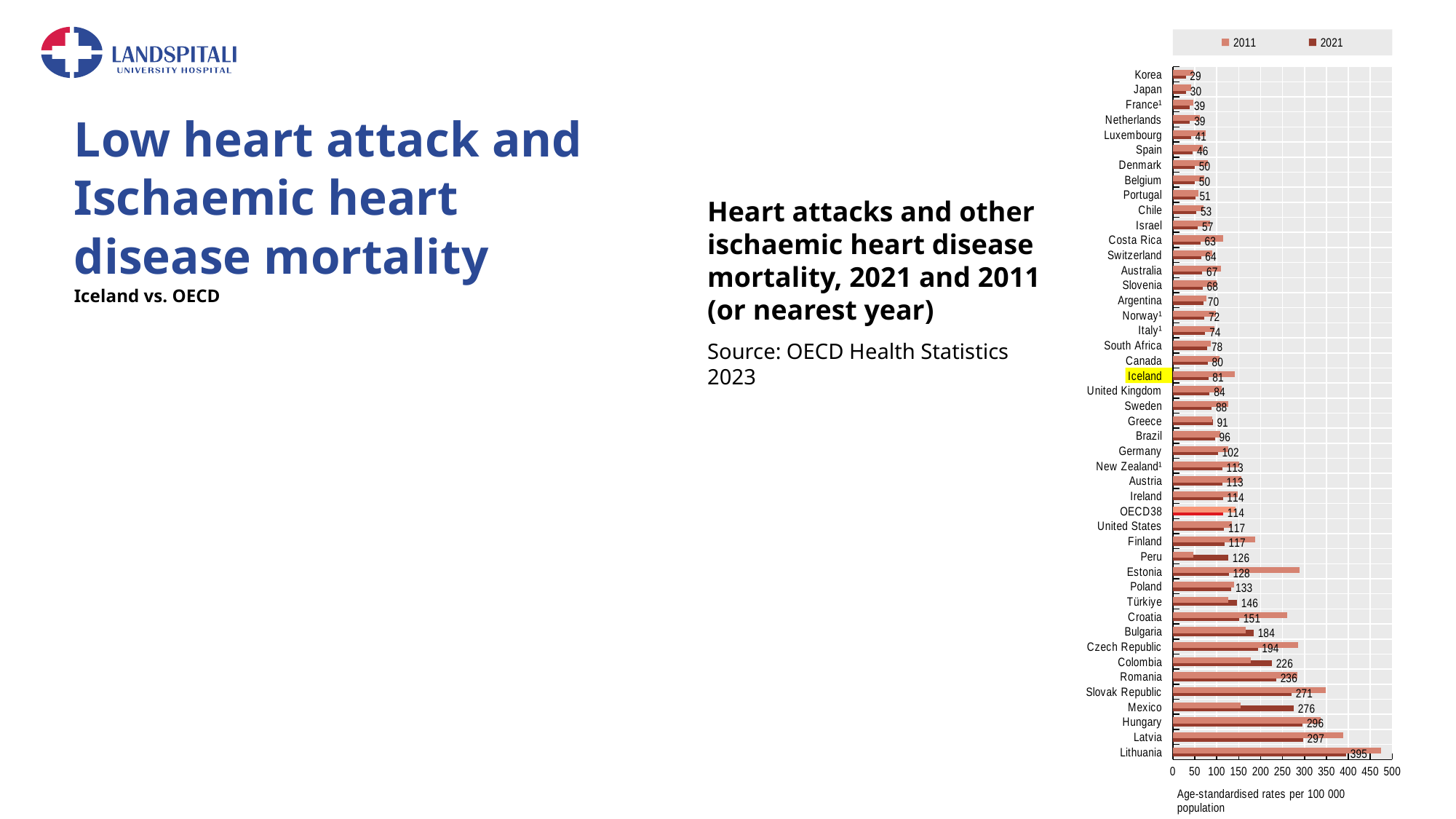
What is the 2021 value for OECD38? 114 What kind of chart is shown on the slide? Bar chart Which country has the lowest 2021 value? Korea How many series does the legend list? 2 What is the difference between the 2021 values for OECD38 and Iceland? 33 What is the 2021 value for Iceland? 81 What is the 2021 value for Lithuania? 395 Which has the larger 2021 value, Mexico or Hungary? Hungary Is the 2011 value for Lithuania greater or less than 450? greater Which country has the highest 2021 value? Lithuania What is the difference between the 2021 values for Lithuania and Latvia? 98 Which country label is highlighted in yellow on the chart? Iceland